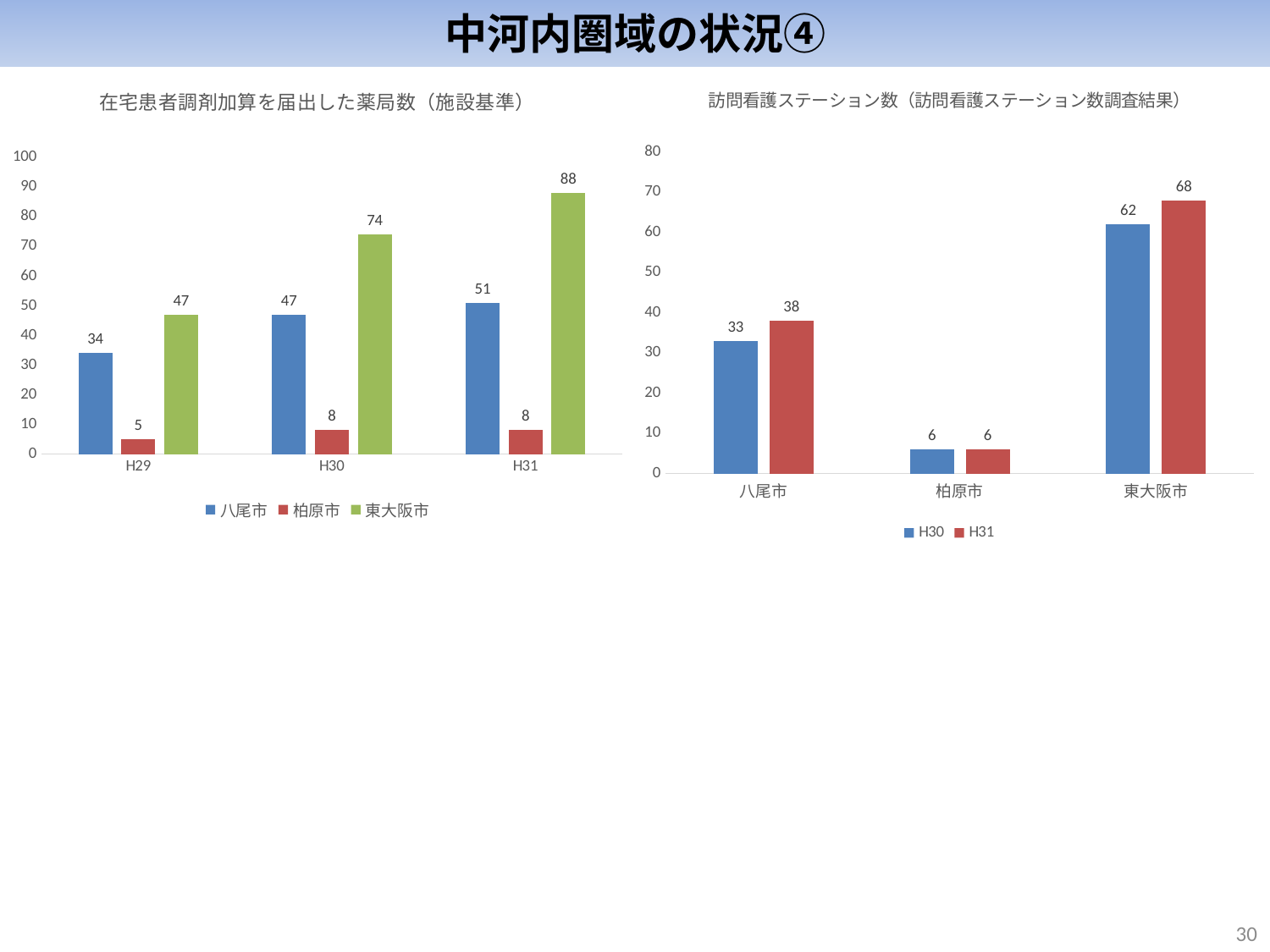
In the left chart (在宅患者調剤加算を届出した薬局数), what is the difference between 東大阪市 and 八尾市 in H30? 27 In the right chart (訪問看護ステーション数), what is the difference between H31 and H30 for 八尾市? 5 In the left chart (在宅患者調剤加算を届出した薬局数), what is the value for 八尾市 in H29? 34 In the left chart (在宅患者調剤加算を届出した薬局数), does the value for 東大阪市 rise or fall from H29 to H31? rise In the left chart (在宅患者調剤加算を届出した薬局数), what is the value for 柏原市 in H30? 8 In the left chart (在宅患者調剤加算を届出した薬局数), how many series does the legend list? 3 In the left chart (在宅患者調剤加算を届出した薬局数), what is the value for 東大阪市 in H31? 88 In the right chart (訪問看護ステーション数), what is the value for 八尾市 in H30? 33 In the right chart (訪問看護ステーション数), which city has the lowest value in H31? 柏原市 What kind of chart is the right chart (訪問看護ステーション数)? bar chart In the left chart (在宅患者調剤加算を届出した薬局数), which series has the highest value in H31? 東大阪市 In the right chart (訪問看護ステーション数), what is the value for 東大阪市 in H31? 68